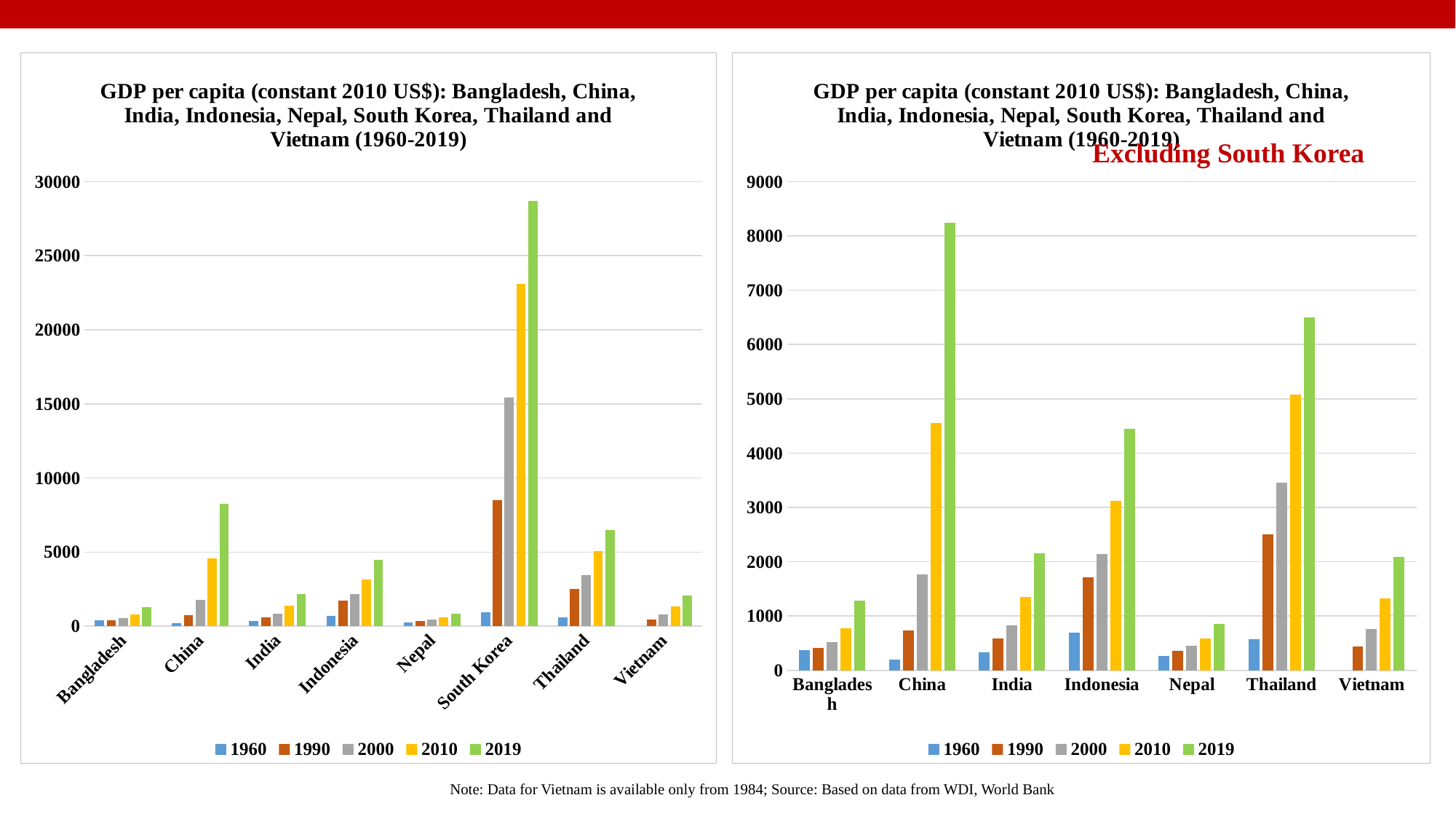
How many series does the legend of the left chart list? 5 In the right chart, which country has the lowest 2019 value? Nepal In the left chart, is the 2010 value for South Korea greater or less than 20000? greater In the right chart, is the 2019 value for China greater or less than 7000? greater How many countries are shown on the x axis of the left chart? 8 In the right chart, which is larger: the 2019 value for Indonesia or the 2019 value for Thailand? Thailand In the right chart, which country has the highest 2019 value? China In the left chart, is the 2019 value for South Korea greater or less than 25000? greater In the left chart, which country has the highest 2019 value? South Korea How many countries are shown on the x axis of the right chart? 7 What red annotation is written on the right chart? Excluding South Korea What kind of chart is the left chart? bar chart